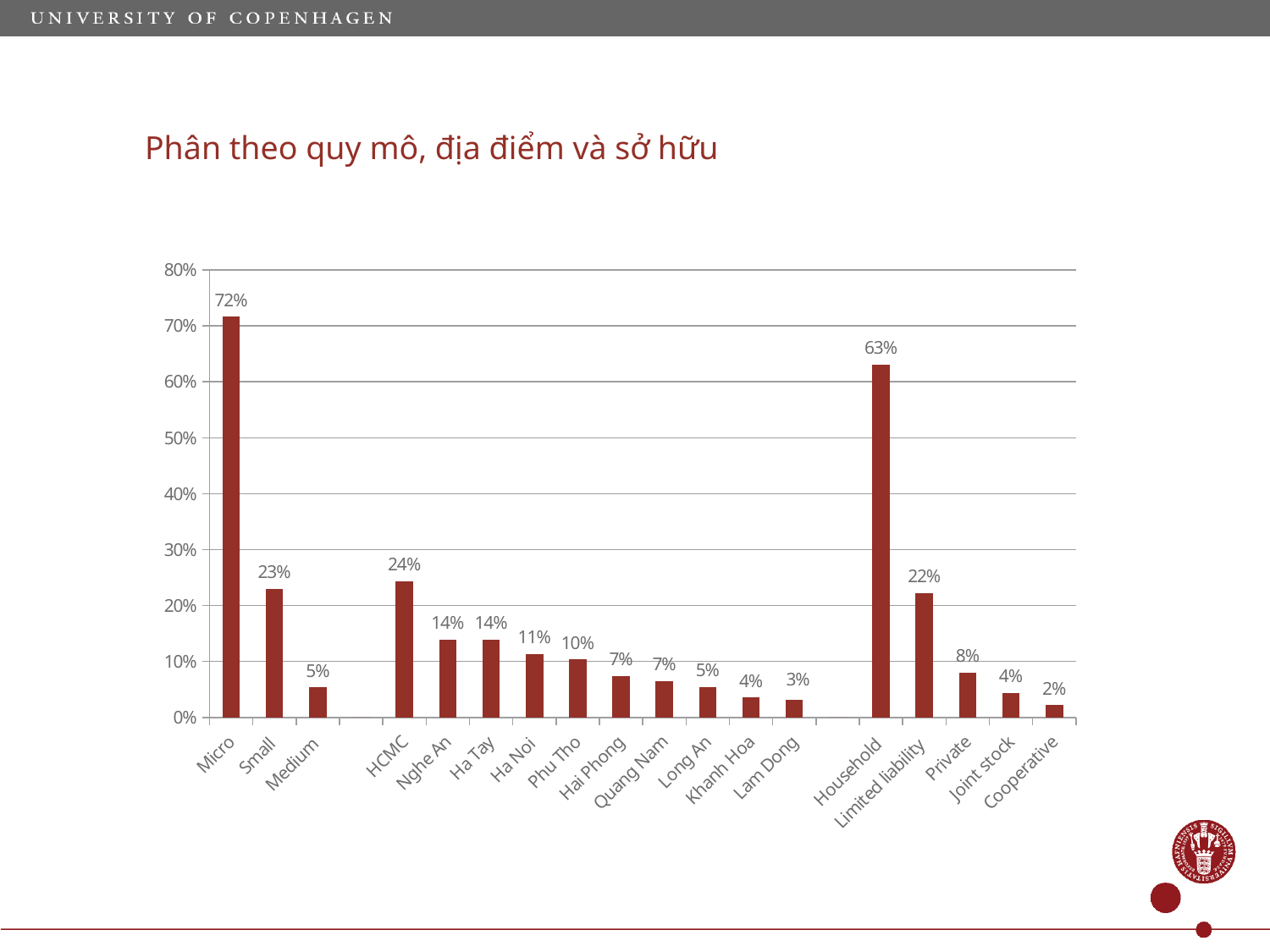
How many categories are shown on the x axis of the chart? 18 What is the value for HCMC? 24% What is the value for Micro? 72% Which category has the lowest value in the chart? Cooperative What is the title of the slide above the chart? Phân theo quy mô, địa điểm và sở hữu What is the difference between the values for Household and Limited liability? 41% Which category has the highest value in the chart? Micro Which is larger, the value for HCMC or the value for Ha Noi? HCMC What is the value for Limited liability? 22% What is the value for Household? 63% What kind of chart is shown on the slide? Bar chart What is the difference between the values for Micro and Small? 49%